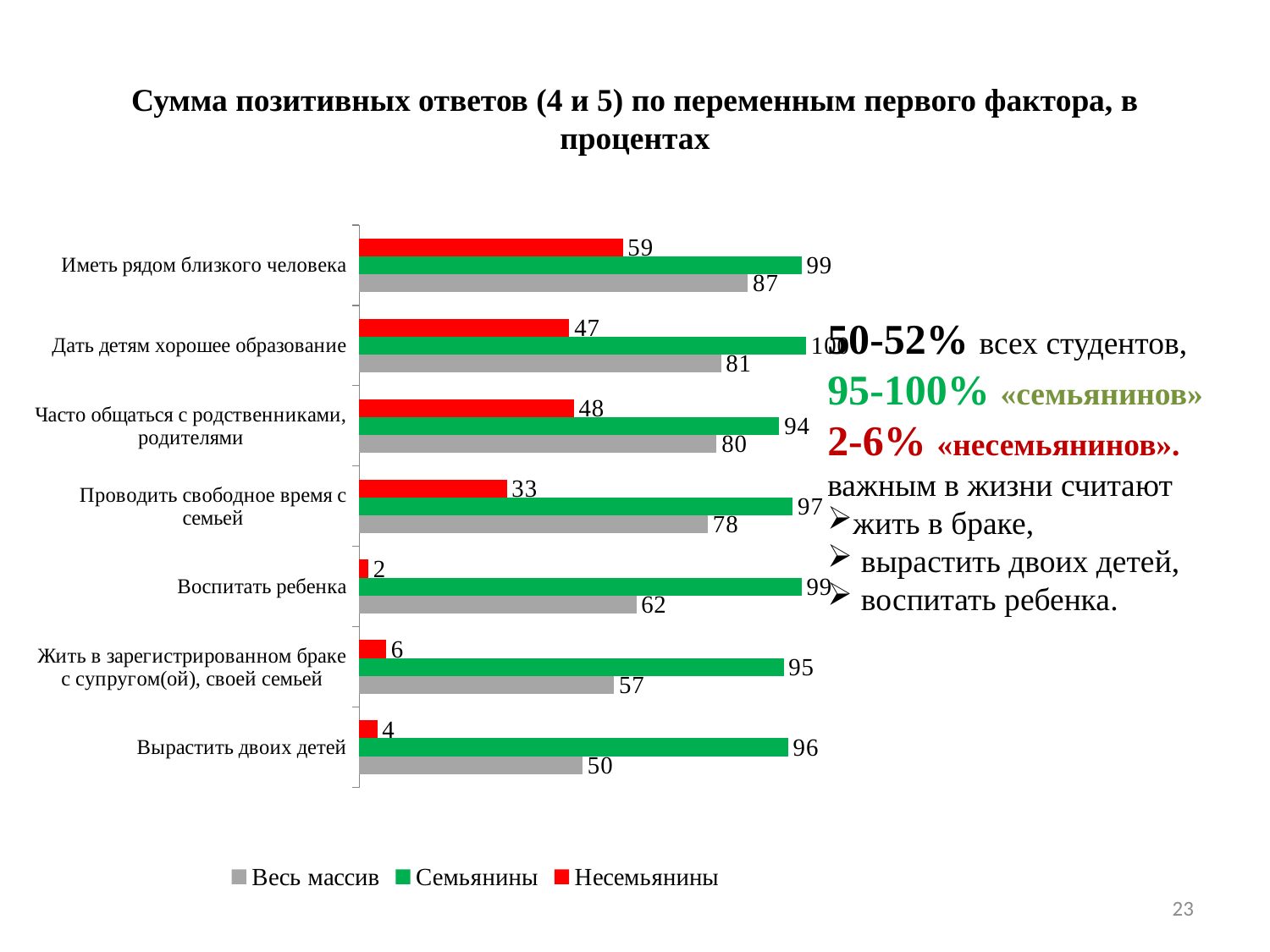
Which is larger for 'Часто общаться с родственниками, родителями': the Весь массив value or the Несемьянины value? Весь массив How many categories are shown on the chart? 7 How many series does the legend list? 3 What is the value for Семьянины for 'Проводить свободное время с семьей'? 97 What is the value for Несемьянины for 'Иметь рядом близкого человека'? 59 What is the value for Весь массив for 'Вырастить двоих детей'? 50 What is the difference between the Весь массив values for 'Дать детям хорошее образование' and 'Жить в зарегистрированном браке с супругом(ой), своей семьей'? 24 Which category has the highest value for Весь массив? Иметь рядом близкого человека What kind of chart is shown on the slide? bar chart Which category has the lowest value for Несемьянины? Воспитать ребенка What is the difference between the Семьянины and Несемьянины values for 'Воспитать ребенка'? 97 Which colour represents the Семьянины series in the chart? green